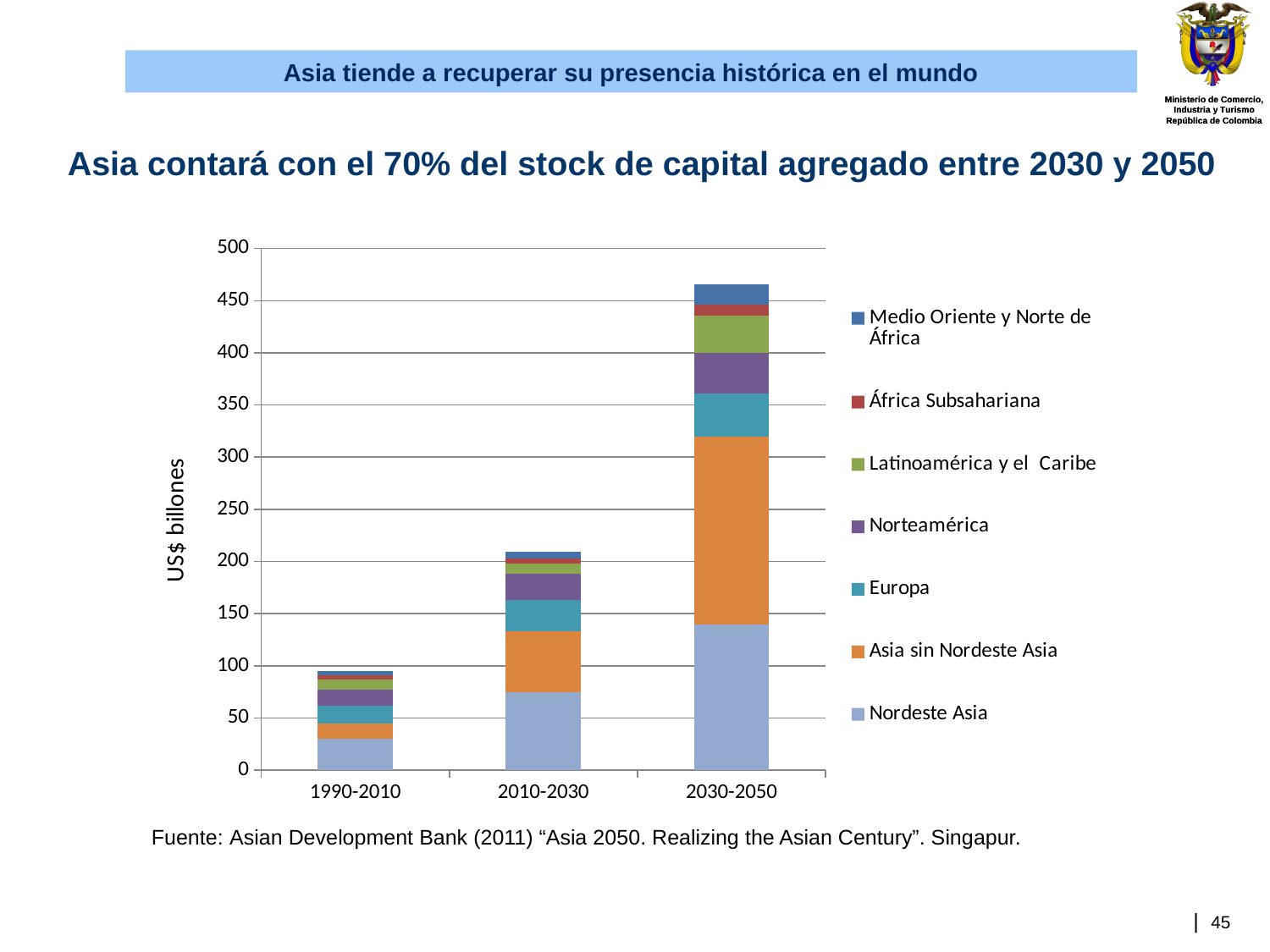
Is the total of the stacked bar for 2010-2030 greater or less than 250? less How many periods are shown on the x axis of the chart? 3 What kind of chart is shown on the slide? Stacked bar chart Is the total of the stacked bar for 2030-2050 greater or less than 400? greater Which series is shown at the bottom of each stacked bar? Nordeste Asia Which period has the shortest stacked bar? 1990-2010 How many series does the chart's legend list? 7 Which period has the tallest stacked bar? 2030-2050 What is the label on the y axis of the chart? US$ billones Do the stacked bar totals rise or fall from 1990-2010 to 2030-2050? Rise Is the total of the stacked bar for 1990-2010 greater or less than 150? less In the 2030-2050 bar, which segment is larger: Asia sin Nordeste Asia or Nordeste Asia? Asia sin Nordeste Asia